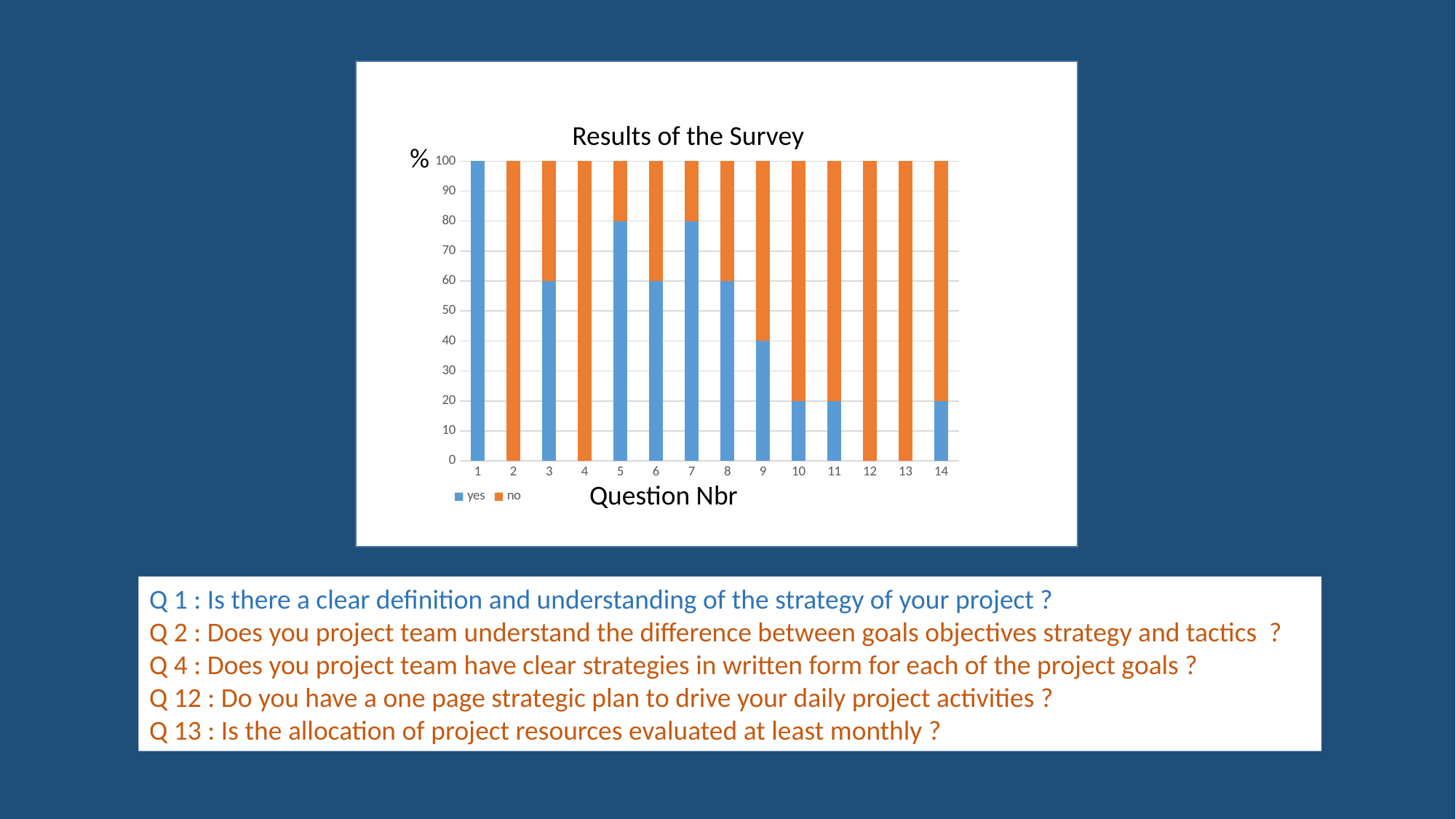
Is the 'yes' value for question 3 greater or less than 50? greater What is the difference between the 'yes' values for question 5 and question 9? 40 What is the 'yes' value for question 10? 20 What is the title of the chart? Results of the Survey What is the 'yes' value for question 1? 100 Which has a larger 'yes' value, question 7 or question 8? question 7 Which question number has the highest 'yes' value? 1 How many series does the legend list? 2 What is the 'yes' value for question 5? 80 What kind of chart is shown on the slide? stacked bar chart What is the 'yes' value for question 9? 40 How many question numbers are shown on the x axis? 14